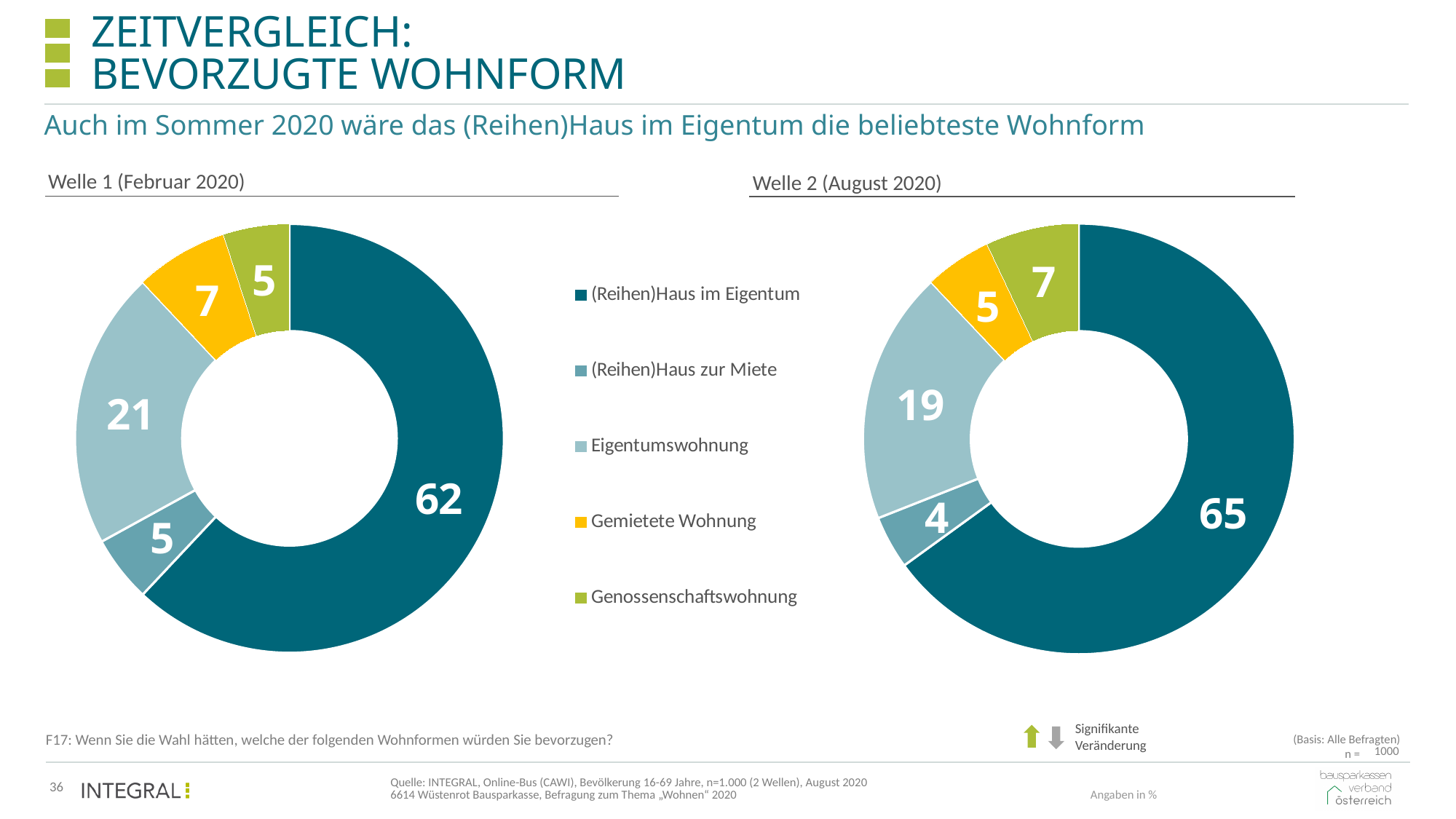
What type of chart is used for Welle 1 (Februar 2020)? Donut (pie) chart In the Welle 2 (August 2020) chart, which category has the lowest value? (Reihen)Haus zur Miete In the Welle 2 (August 2020) chart, what is the value for Eigentumswohnung? 19 In the Welle 1 (Februar 2020) chart, what is the difference between Eigentumswohnung and Gemietete Wohnung? 14 How many categories does each donut chart show? 5 Which is larger: Genossenschaftswohnung in Welle 1 (Februar 2020) or in Welle 2 (August 2020)? Welle 2 (August 2020) In the Welle 2 (August 2020) chart, which category has the highest value? (Reihen)Haus im Eigentum In the Welle 2 (August 2020) chart, what is the value for (Reihen)Haus zur Miete? 4 Which colour represents Gemietete Wohnung in the legend? Yellow In the Welle 1 (Februar 2020) chart, what is the value for Gemietete Wohnung? 7 What is the difference between the (Reihen)Haus im Eigentum value in Welle 2 (August 2020) and in Welle 1 (Februar 2020)? 3 In the Welle 1 (Februar 2020) chart, what is the value for (Reihen)Haus im Eigentum? 62